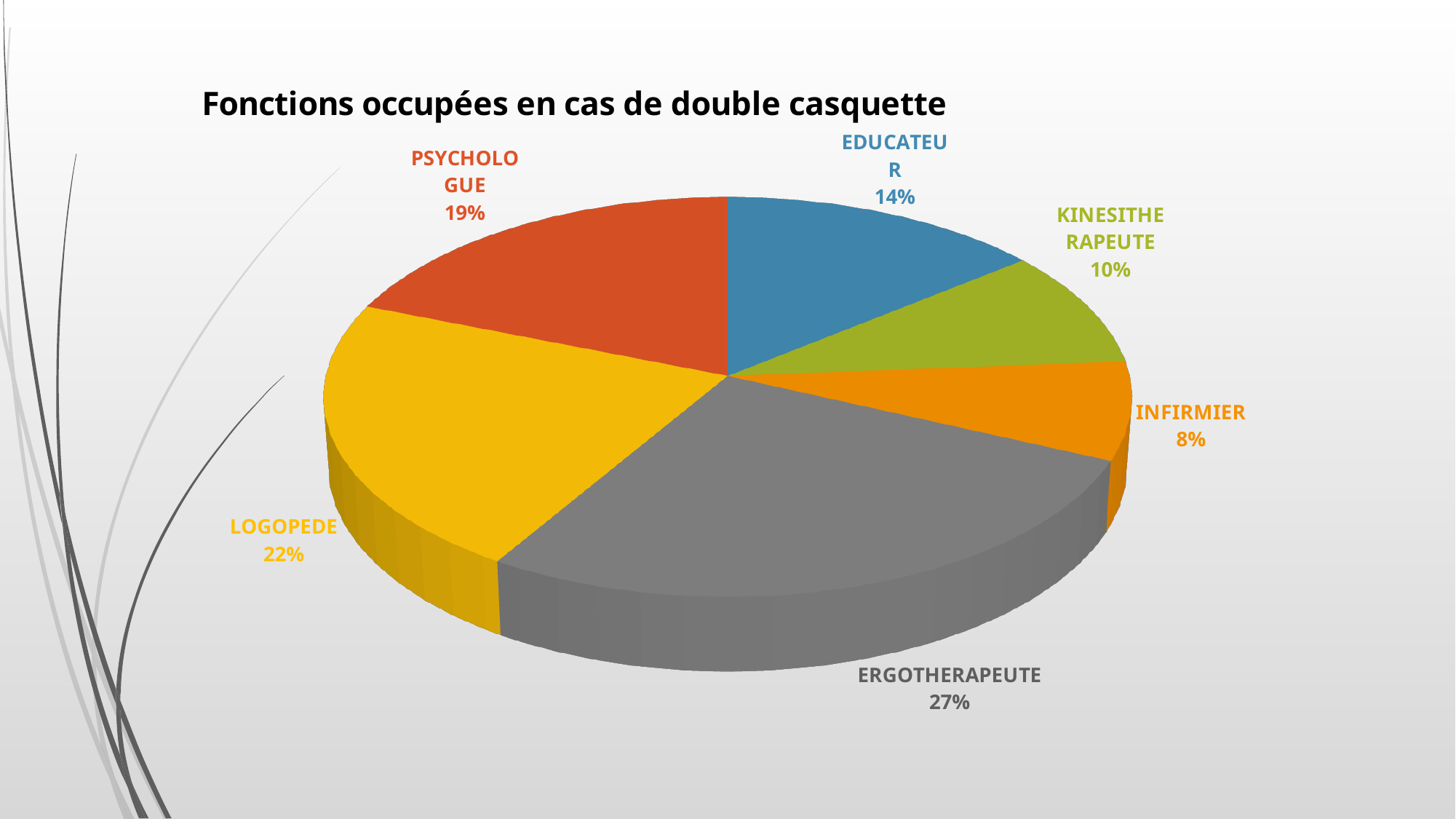
What is the difference in percentage points between ERGOTHERAPEUTE and LOGOPEDE? 5 Which function has the largest share of the pie? ERGOTHERAPEUTE What is the difference in percentage points between EDUCATEUR and KINESITHERAPEUTE? 4 What percentage is shown for LOGOPEDE? 22% What type of chart is shown on the slide? Pie chart What percentage is shown for INFIRMIER? 8% How many slices does the pie chart have? 6 Which has a larger share, PSYCHOLOGUE or EDUCATEUR? PSYCHOLOGUE Which function has the smallest share of the pie? INFIRMIER What percentage is shown for PSYCHOLOGUE? 19% What is the title of the chart? Fonctions occupées en cas de double casquette What share of the pie does ERGOTHERAPEUTE represent? 27%